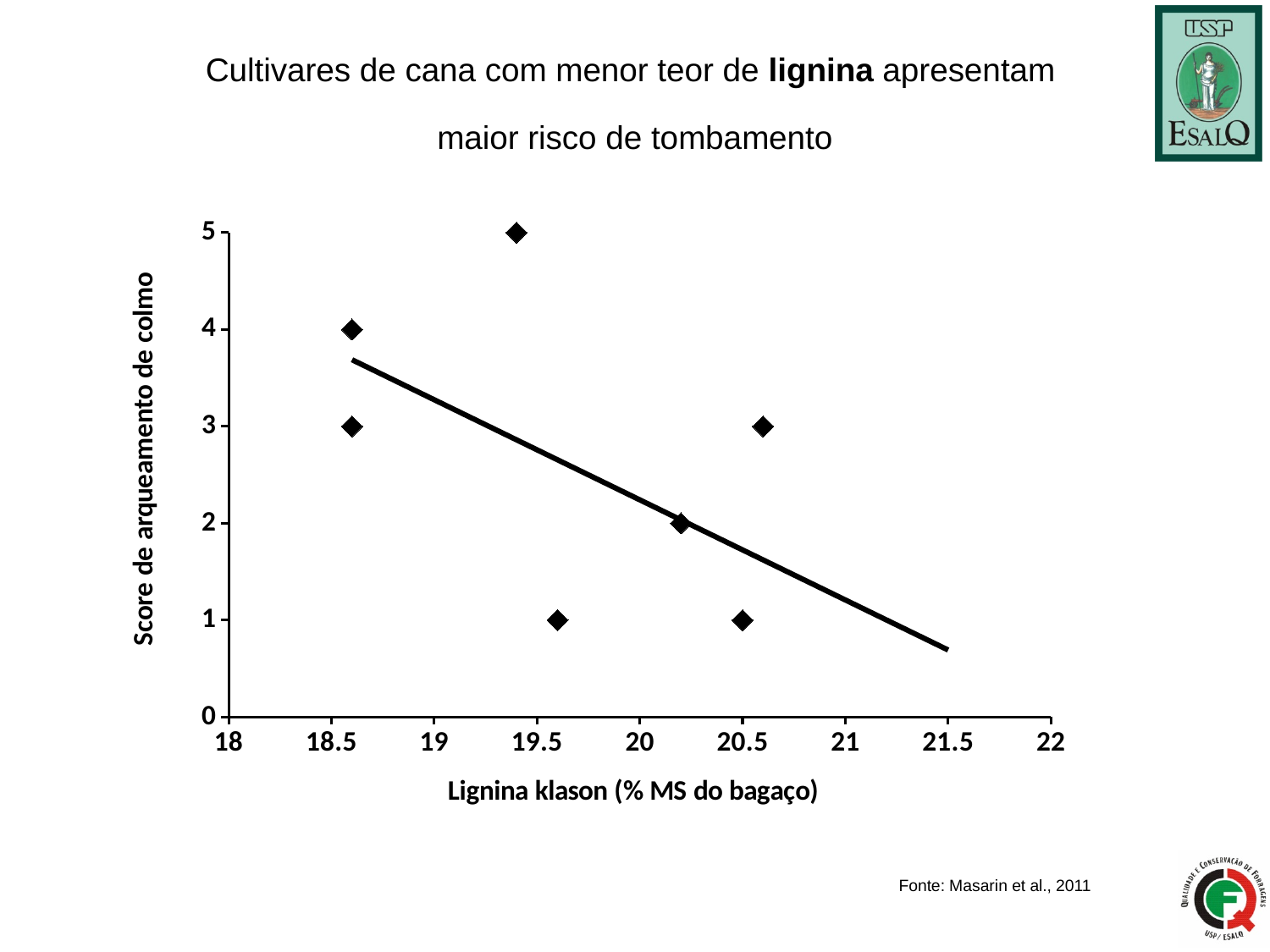
What kind of chart is shown on the slide? scatter plot What is the label of the x axis of the chart? Lignina klason (% MS do bagaço) Is the lignina klason value of the point with score 5 greater or less than 19? greater Is the lignina klason value of the point with score 2 greater or less than 20? greater How many points in the chart have a score de arqueamento de colmo of 3? 2 What is the lowest score de arqueamento de colmo reached by any point in the chart? 1 What is the label of the y axis of the chart? Score de arqueamento de colmo Does the trend line show the score de arqueamento de colmo rising or falling as lignina klason increases? falling What is the highest score de arqueamento de colmo reached by any point in the chart? 5 Is the lignina klason value of the point with score 4 greater or less than 19? less